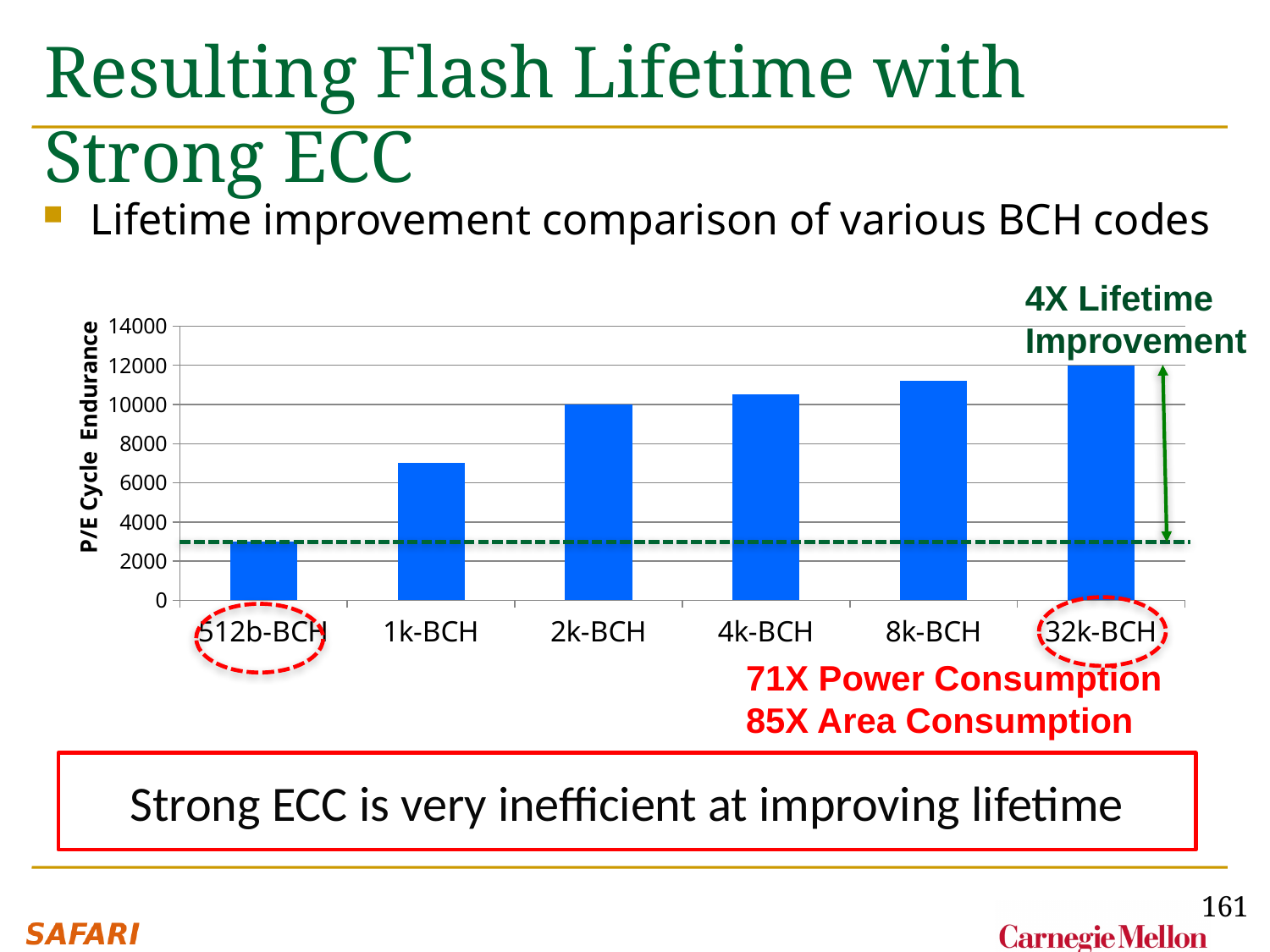
What kind of chart is shown on the slide? bar chart Which BCH code has the highest P/E Cycle Endurance? 32k-BCH What lifetime improvement does the green annotation above the 32k-BCH bar state? 4X Lifetime Improvement Do the P/E Cycle Endurance values rise or fall from 512b-BCH to 32k-BCH along the x axis? rise How many BCH code categories are plotted on the x axis? 6 Is the P/E Cycle Endurance for 1k-BCH greater or less than 6000? greater Which BCH code has the lowest P/E Cycle Endurance? 512b-BCH What is the label of the y axis? P/E Cycle Endurance Which has a higher P/E Cycle Endurance, 1k-BCH or 2k-BCH? 2k-BCH Is the P/E Cycle Endurance for 4k-BCH greater or less than 8000? greater Is the P/E Cycle Endurance for 8k-BCH greater or less than 10000? greater